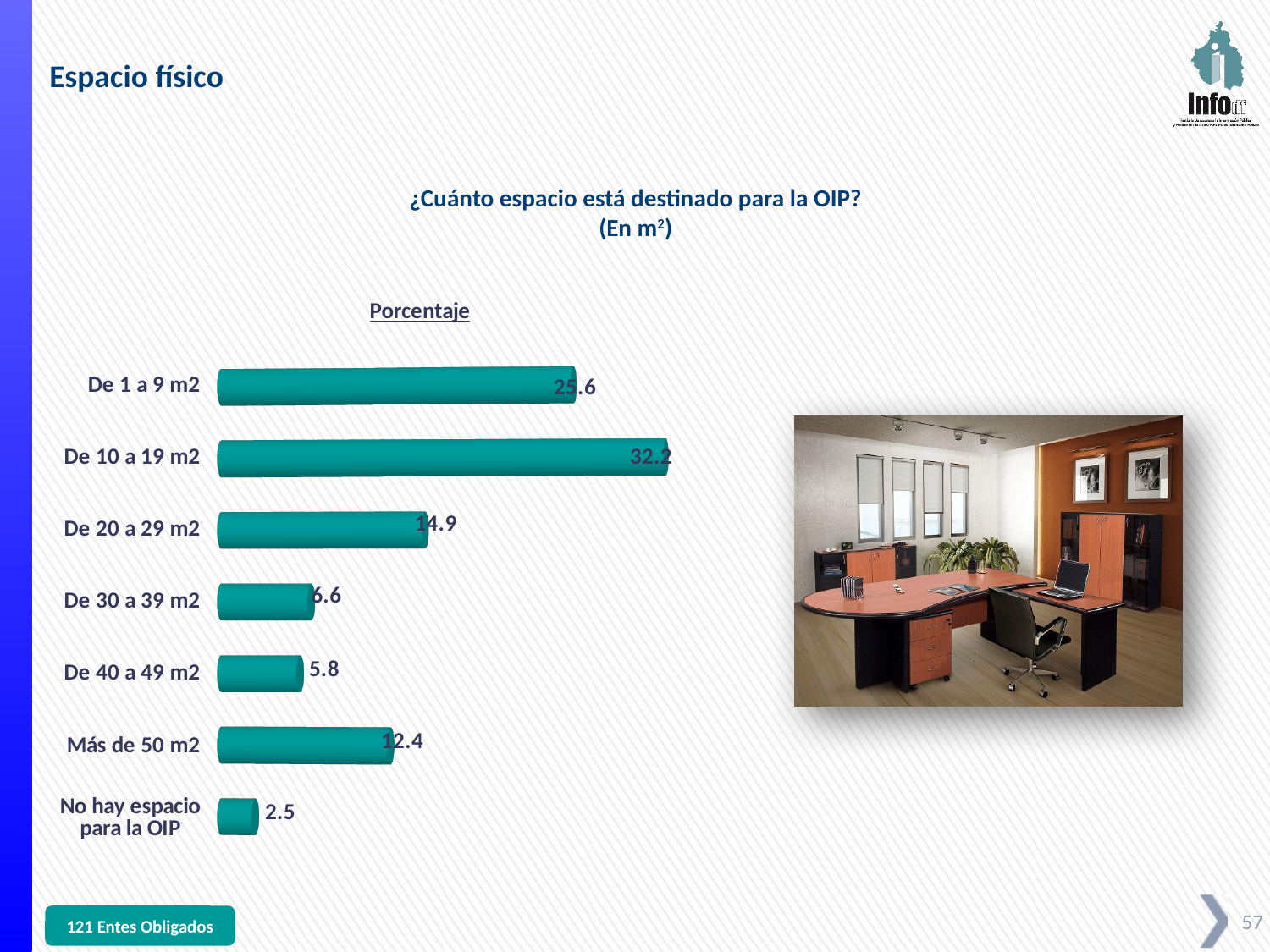
How many categories are shown in the chart? 7 Which category has the highest value? De 10 a 19 m2 What is the difference between the values for "De 20 a 29 m2" and "Más de 50 m2"? 2.5 Which category has the lowest value? No hay espacio para la OIP What is the title of the chart? Porcentaje Which is larger, the value for "De 30 a 39 m2" or the value for "De 40 a 49 m2"? De 30 a 39 m2 What is the value for "De 1 a 9 m2"? 25.6 What is the value for "De 10 a 19 m2"? 32.2 What kind of chart is shown on the slide? Bar chart What is the value for "Más de 50 m2"? 12.4 What is the difference between the values for "De 10 a 19 m2" and "De 1 a 9 m2"? 6.6 What is the value for "No hay espacio para la OIP"? 2.5